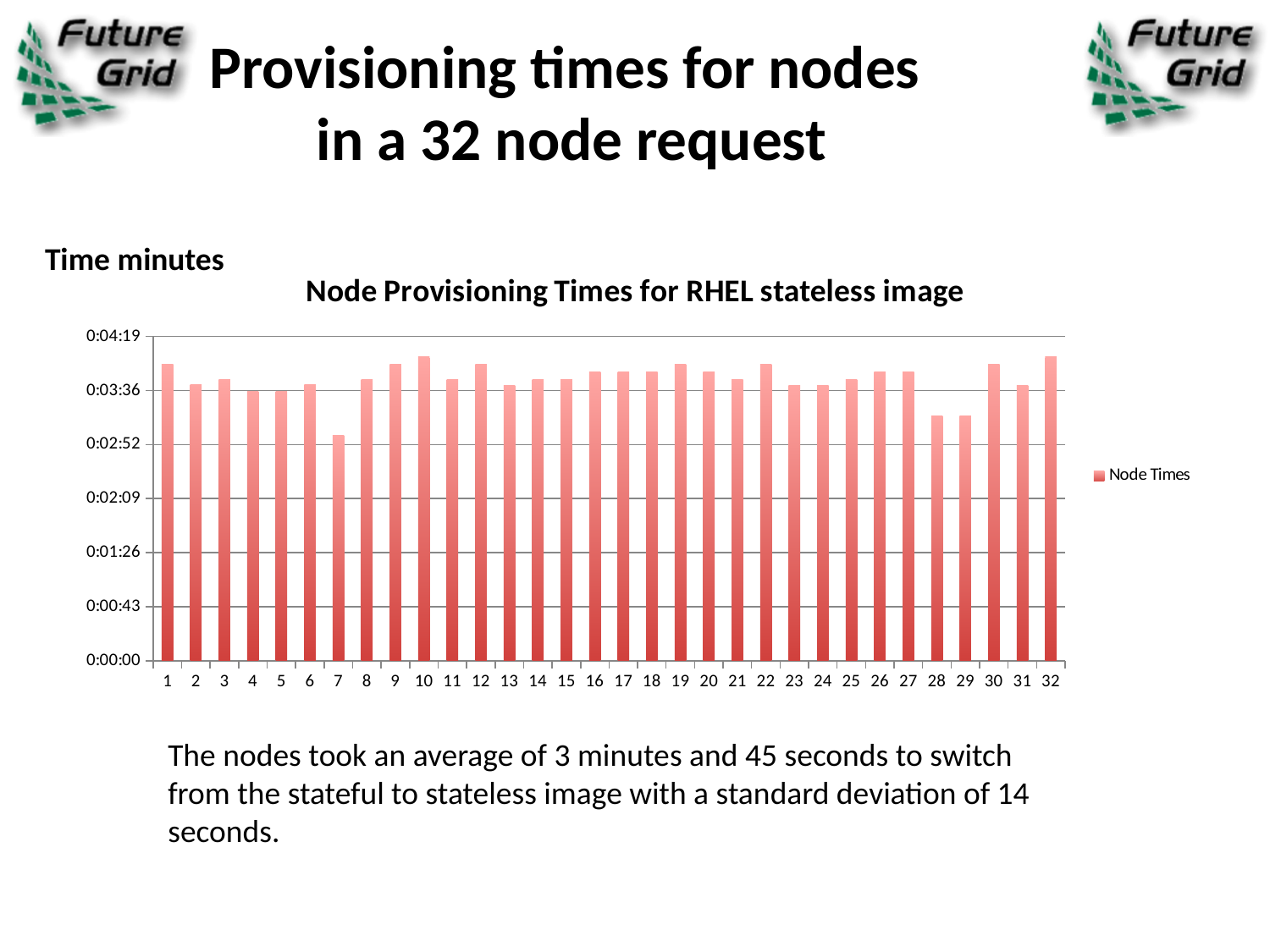
How many series does the legend list? 1 What kind of chart is shown on the slide? Bar chart Which node has the lowest provisioning time? 7 Is the value for node 1 greater or less than 0:03:36? greater Which has the larger provisioning time, node 1 or node 7? Node 1 Is the value for node 7 greater or less than 0:03:36? less Is the value for node 7 greater or less than 0:02:52? greater How many nodes (categories) are plotted along the x axis? 32 What is the name of the series shown in the legend? Node Times Which has the larger provisioning time, node 10 or node 29? Node 10 What is the title of the chart? Node Provisioning Times for RHEL stateless image